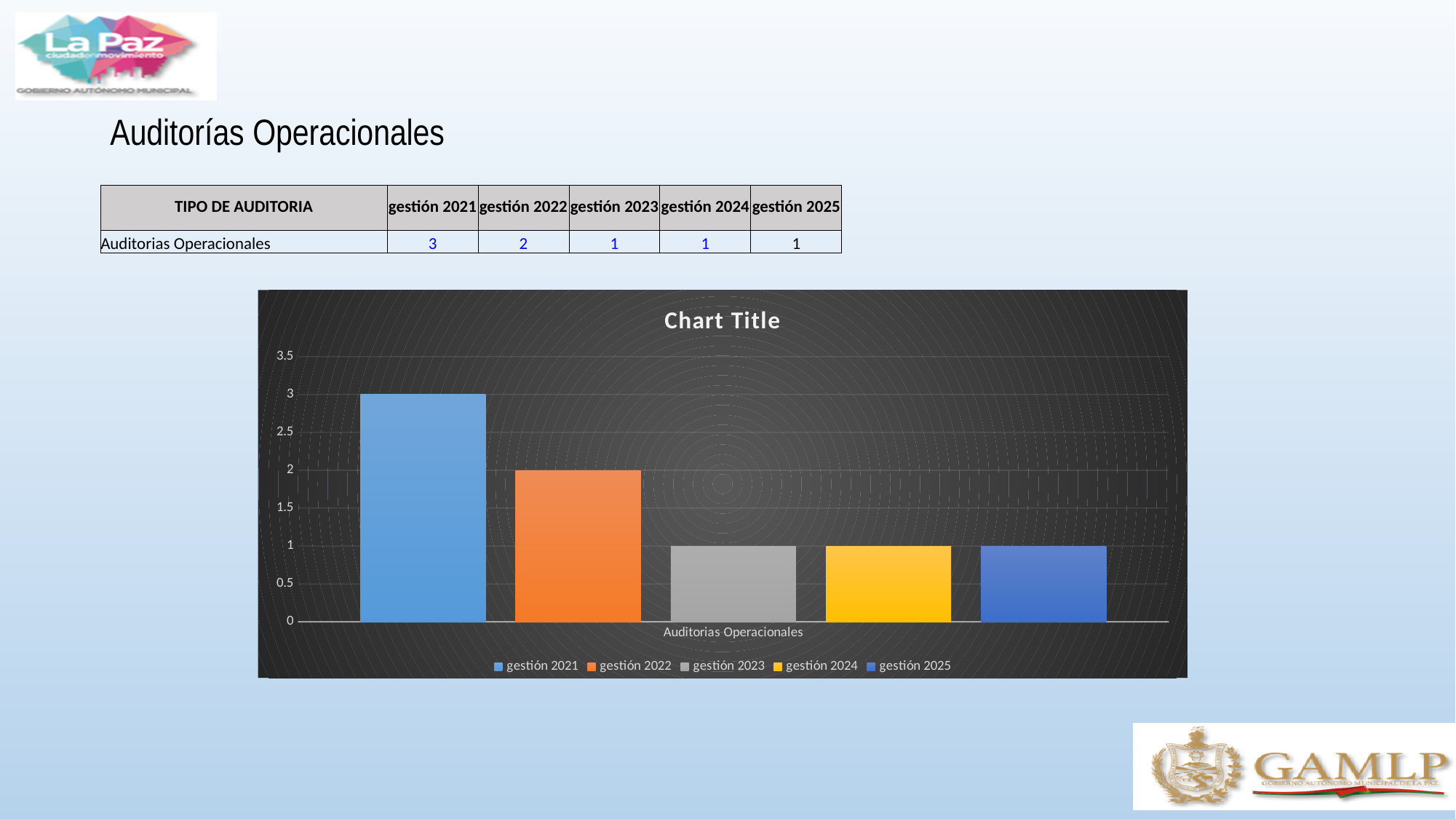
What is the difference between the values for gestión 2021 and gestión 2024? 2 Which series has the highest value in the chart? gestión 2021 Which is larger, the value for gestión 2022 or the value for gestión 2023? gestión 2022 What is the value for gestión 2023 in the chart? 1 Do the values rise or fall from gestión 2021 to gestión 2023? fall What kind of chart is shown on the slide? bar chart What is the value for gestión 2021 in the chart? 3 How many series does the chart legend list? 5 What is the value for gestión 2025 in the chart? 1 What is the difference between the values for gestión 2021 and gestión 2022? 1 What is the value for gestión 2022 in the chart? 2 What is the title shown on the chart? Chart Title